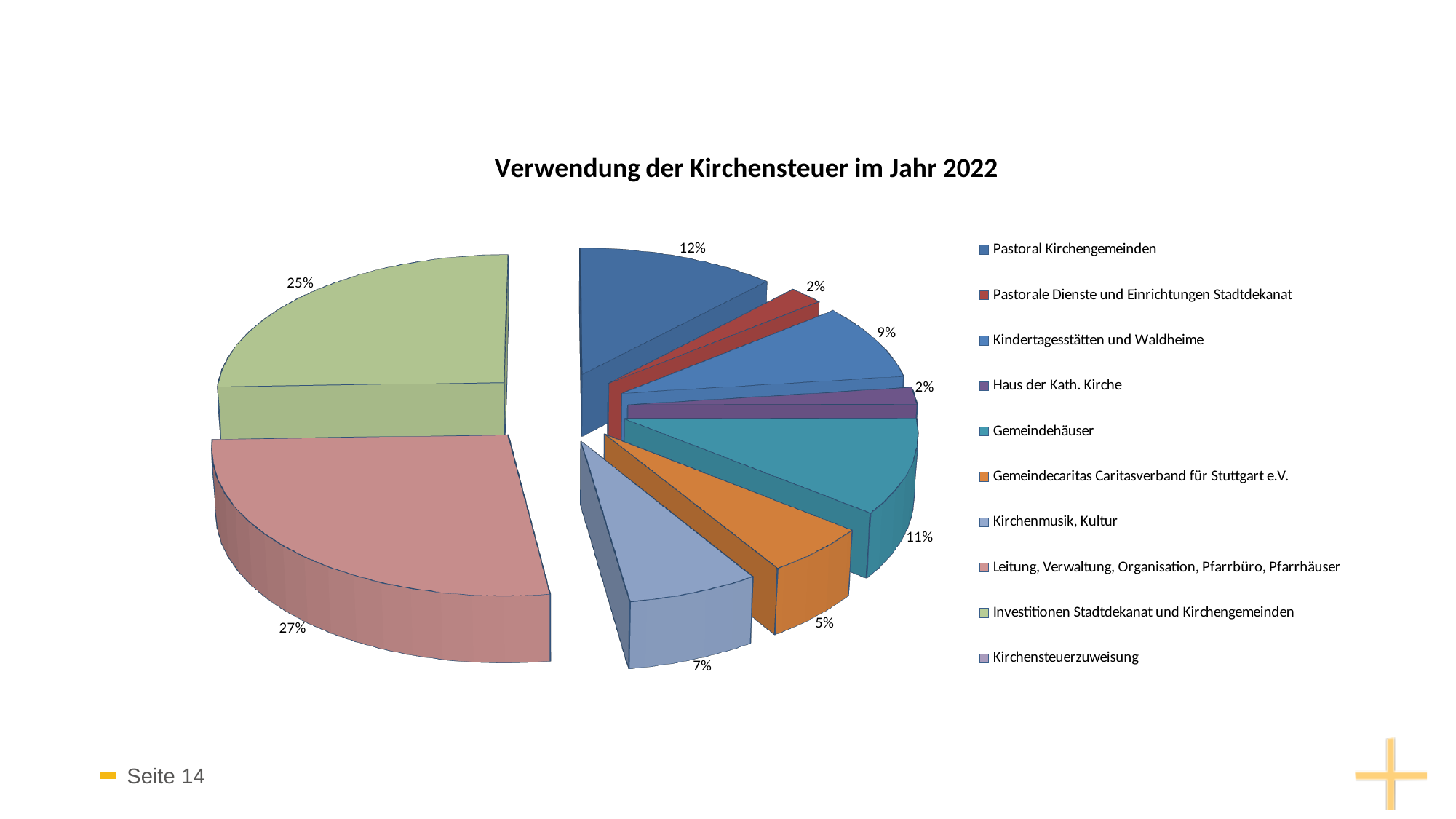
What share is shown for Kirchenmusik, Kultur? 7% What percentage is shown for Investitionen Stadtdekanat und Kirchengemeinden? 25% What percentage is shown for Leitung, Verwaltung, Organisation, Pfarrbüro, Pfarrhäuser? 27% What share is labelled for Gemeindehäuser? 11% What is the title of the chart? Verwendung der Kirchensteuer im Jahr 2022 What percentage is shown for Kindertagesstätten und Waldheime? 9% Which category has the largest share of the pie? Leitung, Verwaltung, Organisation, Pfarrbüro, Pfarrhäuser What percentage is shown for Gemeindecaritas Caritasverband für Stuttgart e.V.? 5% Which is larger: the share for Investitionen Stadtdekanat und Kirchengemeinden or the share for Leitung, Verwaltung, Organisation, Pfarrbüro, Pfarrhäuser? Leitung, Verwaltung, Organisation, Pfarrbüro, Pfarrhäuser What kind of chart is shown on the slide? Pie chart How many entries does the legend list? 10 What share of the church tax goes to Pastoral Kirchengemeinden? 12%